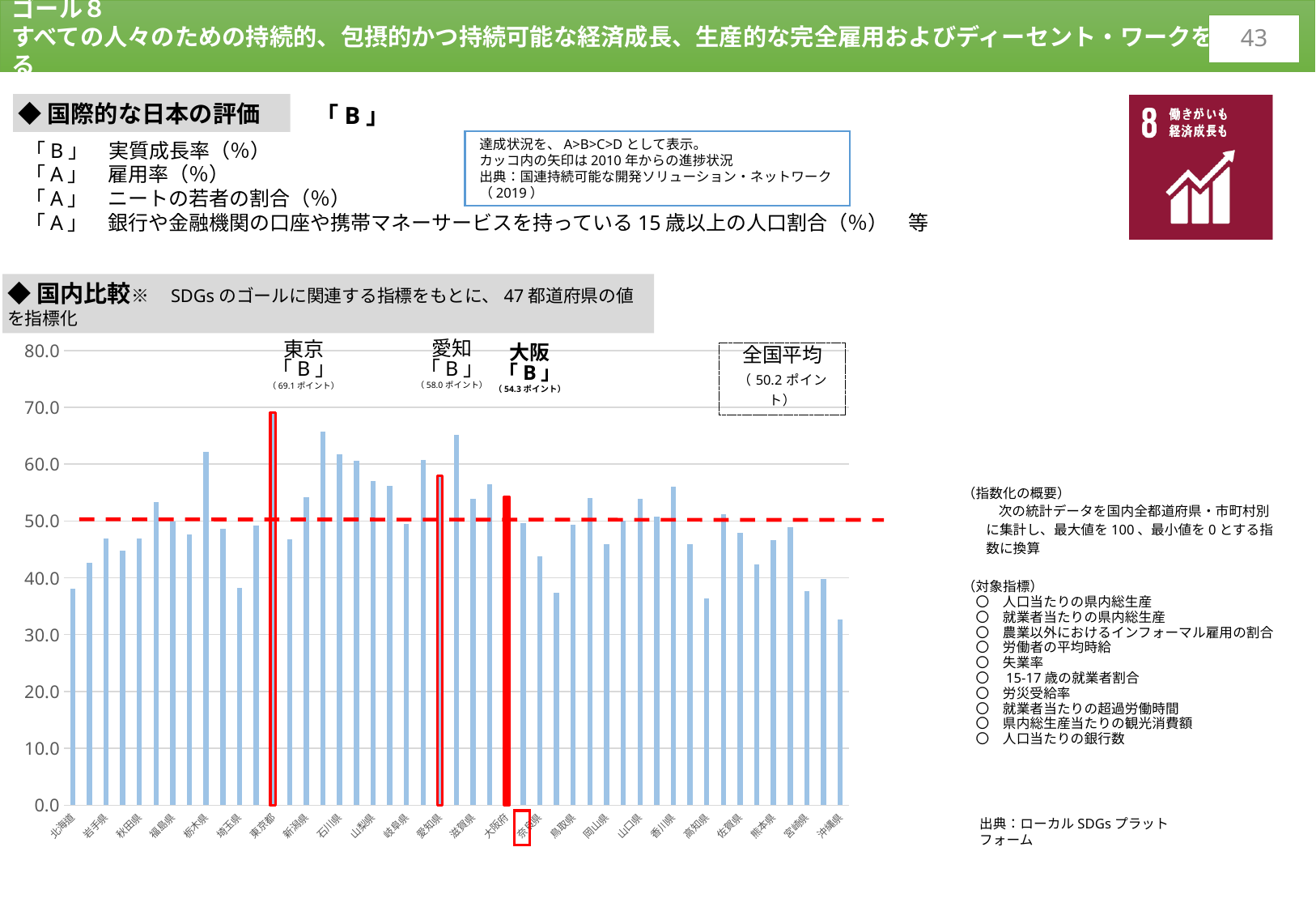
What is the difference between the values for 東京 and 大阪? 14.8 ポイント What is the value shown for 愛知 in the 国内比較 chart? 58.0 ポイント Which has the larger value, 愛知 or 大阪? 愛知 Which prefecture has the lowest bar in the 国内比較 chart? 沖縄県 What is the value shown for 東京 in the 国内比較 chart? 69.1 ポイント Which prefecture has the highest bar in the 国内比較 chart? 東京都 What kind of chart is used for the 国内比較? bar chart How many points higher is 東京 than 愛知 in the 国内比較 chart? 11.1 ポイント Is the value for 石川県 greater or less than 60.0? greater What is the 全国平均 value shown on the chart? 50.2 ポイント Is the value for 奈良県 greater or less than 50.0? less What is the value shown for 大阪 in the 国内比較 chart? 54.3 ポイント